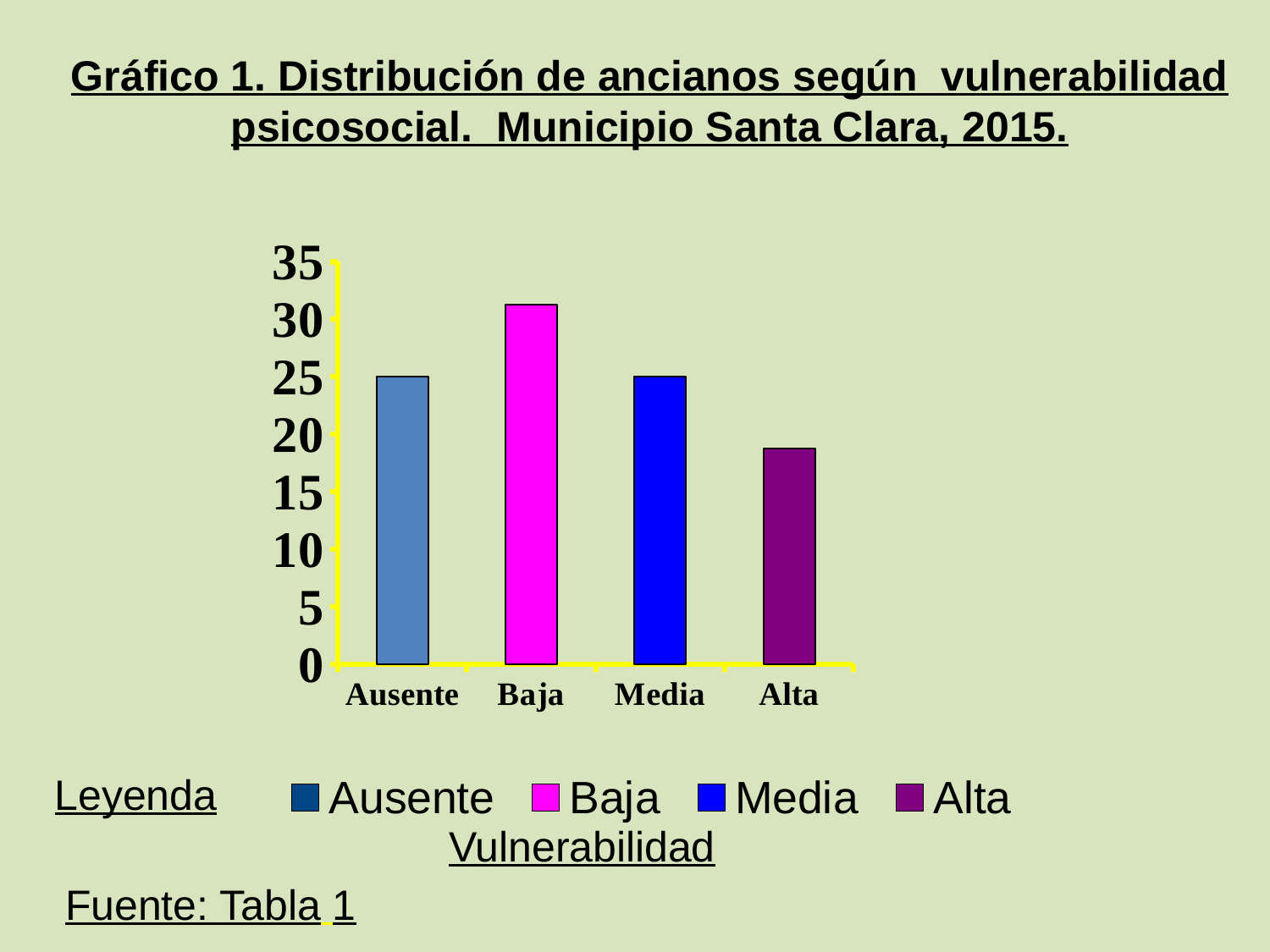
Is the value for Alta greater or less than 20? less What colour is the bar for Baja? magenta How many entries does the legend list? 4 Is the value for Ausente greater or less than 20? greater What kind of chart is shown on the slide? bar chart Which vulnerability category has the highest bar? Baja Which vulnerability category has the lowest bar? Alta How many categories are shown on the x axis of the chart? 4 Is the value for Baja greater or less than 30? greater Which is larger, the value for Baja or the value for Alta? Baja Which is larger, the value for Media or the value for Alta? Media